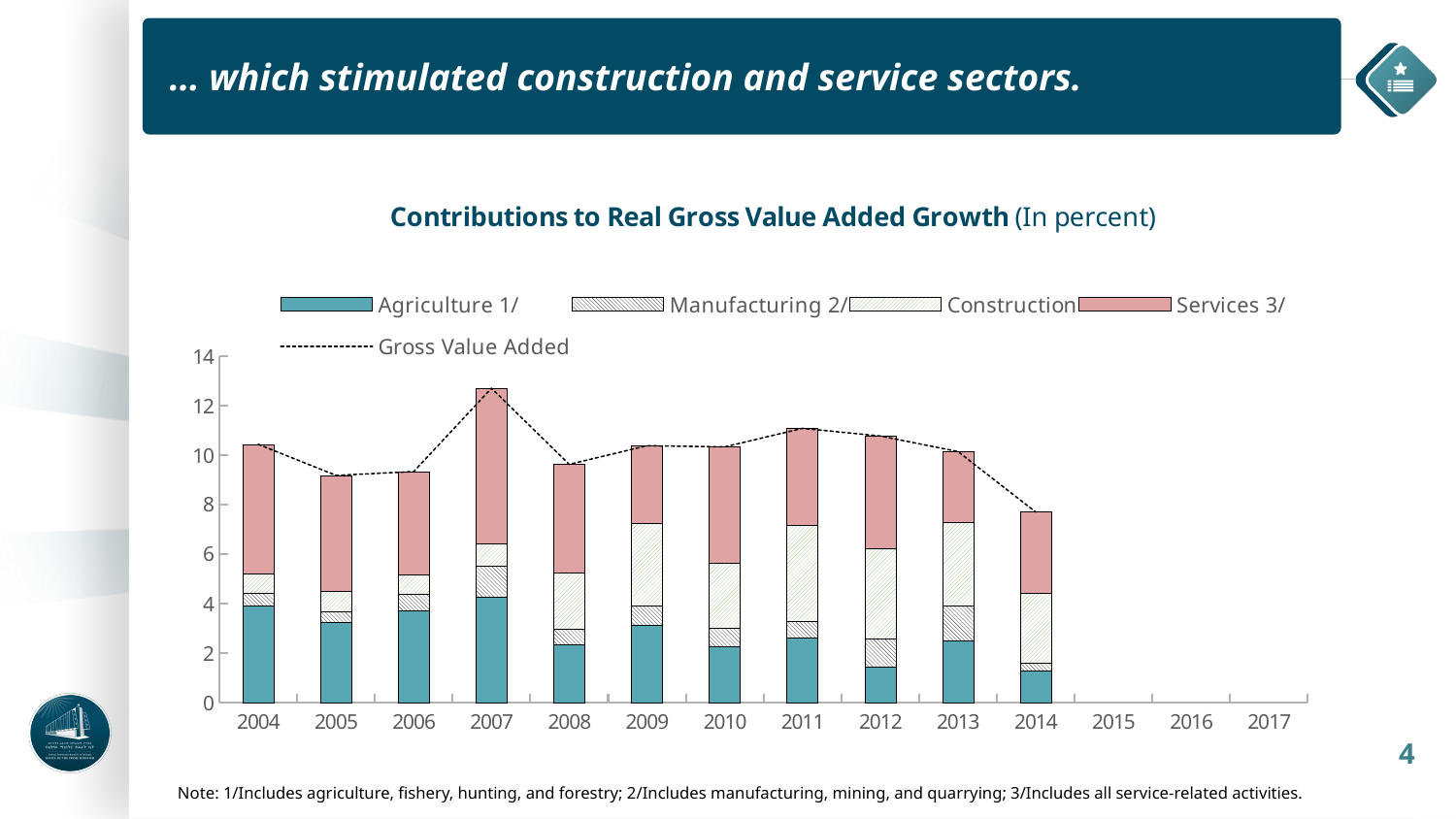
How many years have bars plotted in the chart? 11 Which year has the highest Gross Value Added growth? 2007 Which year has the larger Agriculture contribution, 2004 or 2014? 2004 Is the Gross Value Added growth for 2007 greater or less than 12? greater How many series does the legend list? 5 What kind of chart is shown on the slide? Stacked bar chart with a line Which year has the lowest Gross Value Added growth among the plotted bars? 2014 Is the Agriculture contribution for 2014 greater or less than 2? less Does the Gross Value Added line rise or fall from 2011 to 2014? Fall Is the Gross Value Added growth for 2014 greater or less than 8? less What is the title of the chart? Contributions to Real Gross Value Added Growth (In percent)